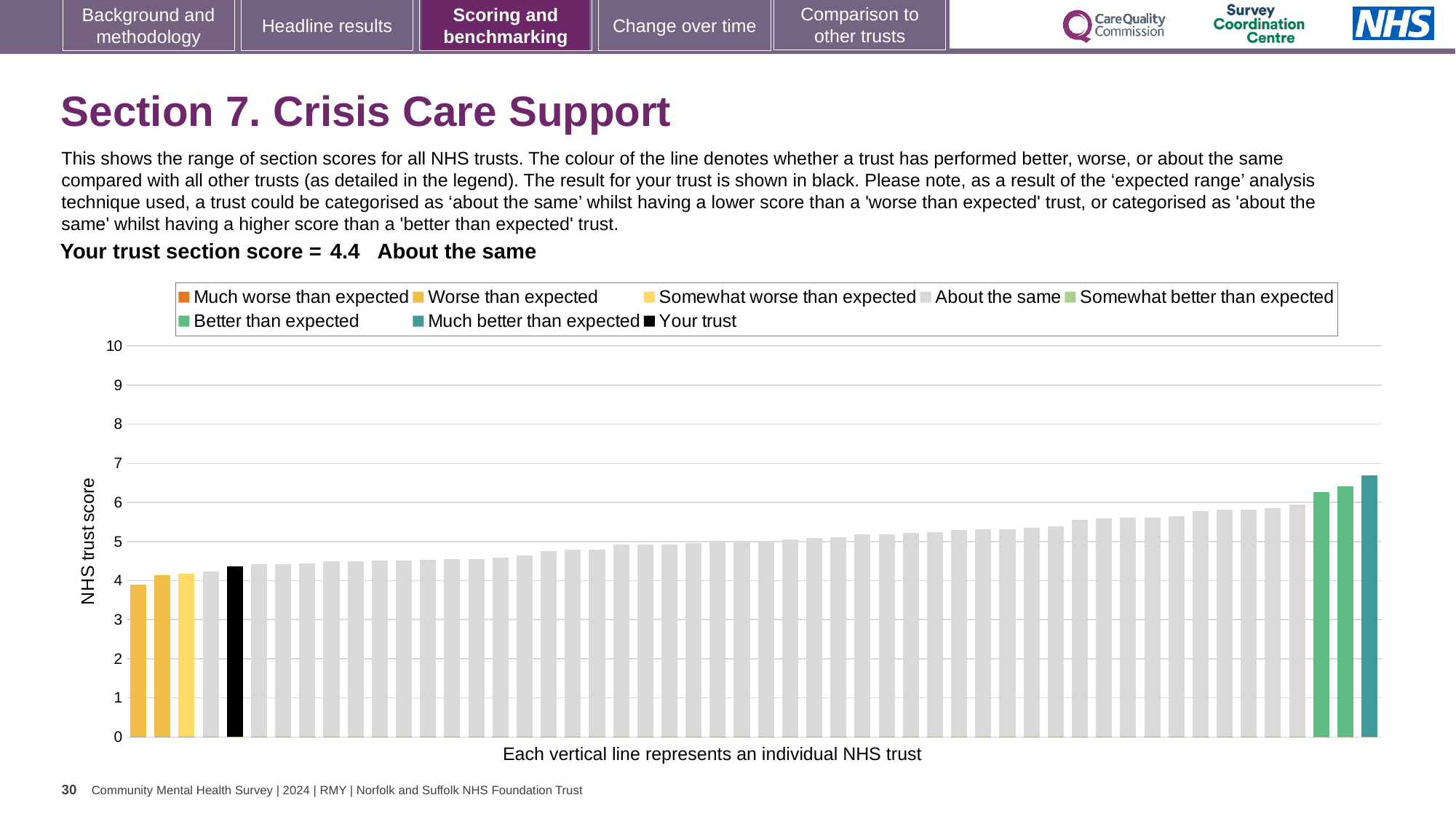
Is the value of the tallest bar on the chart greater or less than 6? greater What is the section score for your trust shown on the slide? 4.4 What is the label on the vertical axis of the chart? NHS trust score Do the bar values rise or fall from left to right along the x axis? rise Is the value of the black 'Your trust' bar greater or less than 5? less What kind of chart is shown on the slide? bar chart How many bars are coloured as 'Better than expected' (green)? 2 Is the value of the shortest bar on the chart greater or less than 5? less How many entries does the chart legend list? 8 Which category is your trust placed in for this section? About the same Which legend category does the tallest bar on the chart belong to? Much better than expected What colour is the bar representing your trust? black